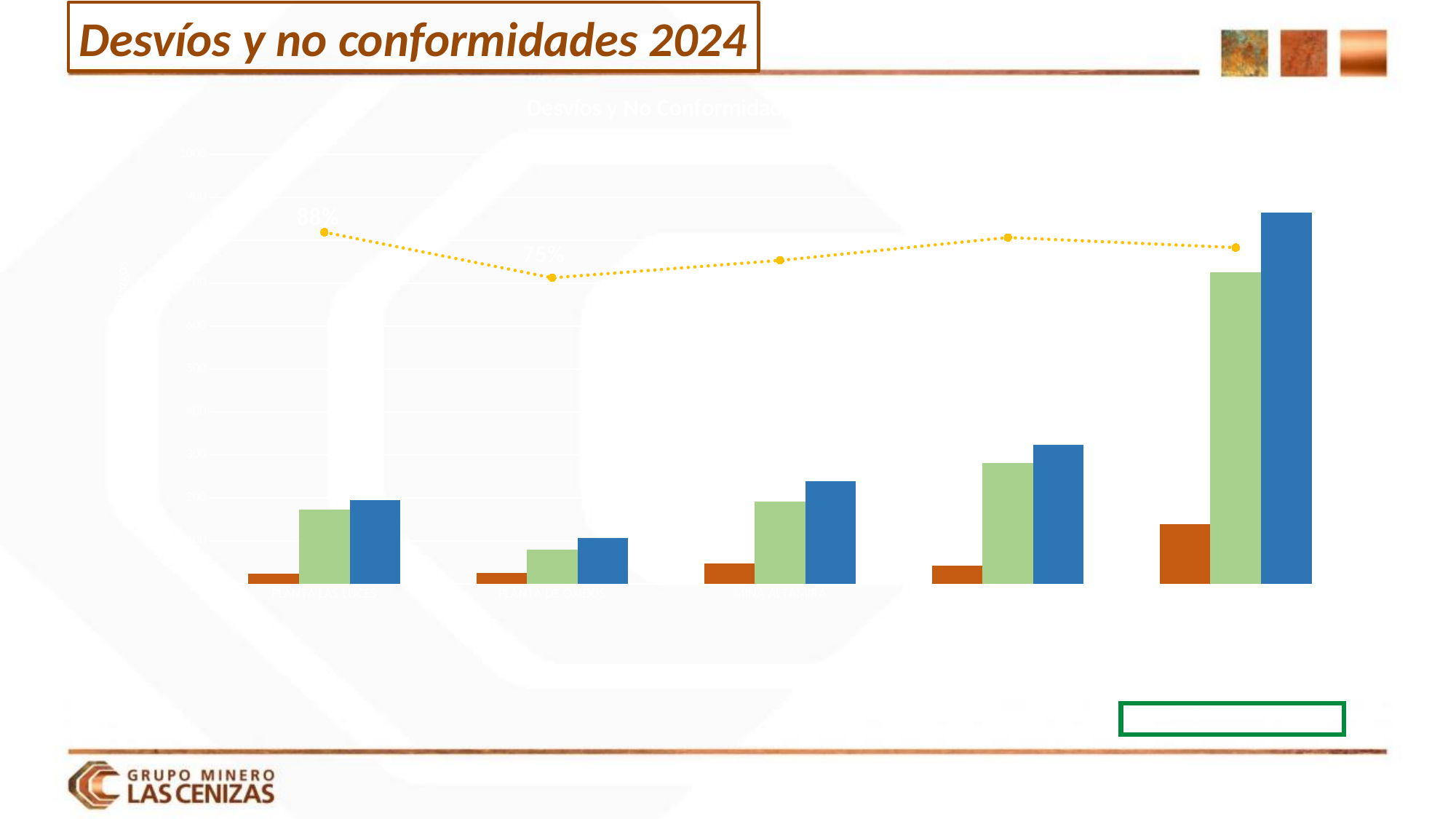
How many bars are there in each group? 3 What kind of chart is shown on the slide? combination bar and line chart At which group of bars does the dotted line reach its lowest point? the second group from the left Which colour bar is the shortest within every group? orange How many groups of bars are plotted along the x axis? 5 Which is larger, the line value above the first group (88%) or above the second group (75%)? 88% (first group) What is the difference between the 88% and 75% labels on the dotted line? 13% Which colour bar is the tallest within every group? blue What percentage is labelled on the dotted line above the first (leftmost) group of bars? 88% Which group of bars has the tallest bar in the chart? the rightmost (fifth) group What is the title shown at the top of the slide? Desvíos y no conformidades 2024 What percentage is labelled on the dotted line above the second group of bars from the left? 75%